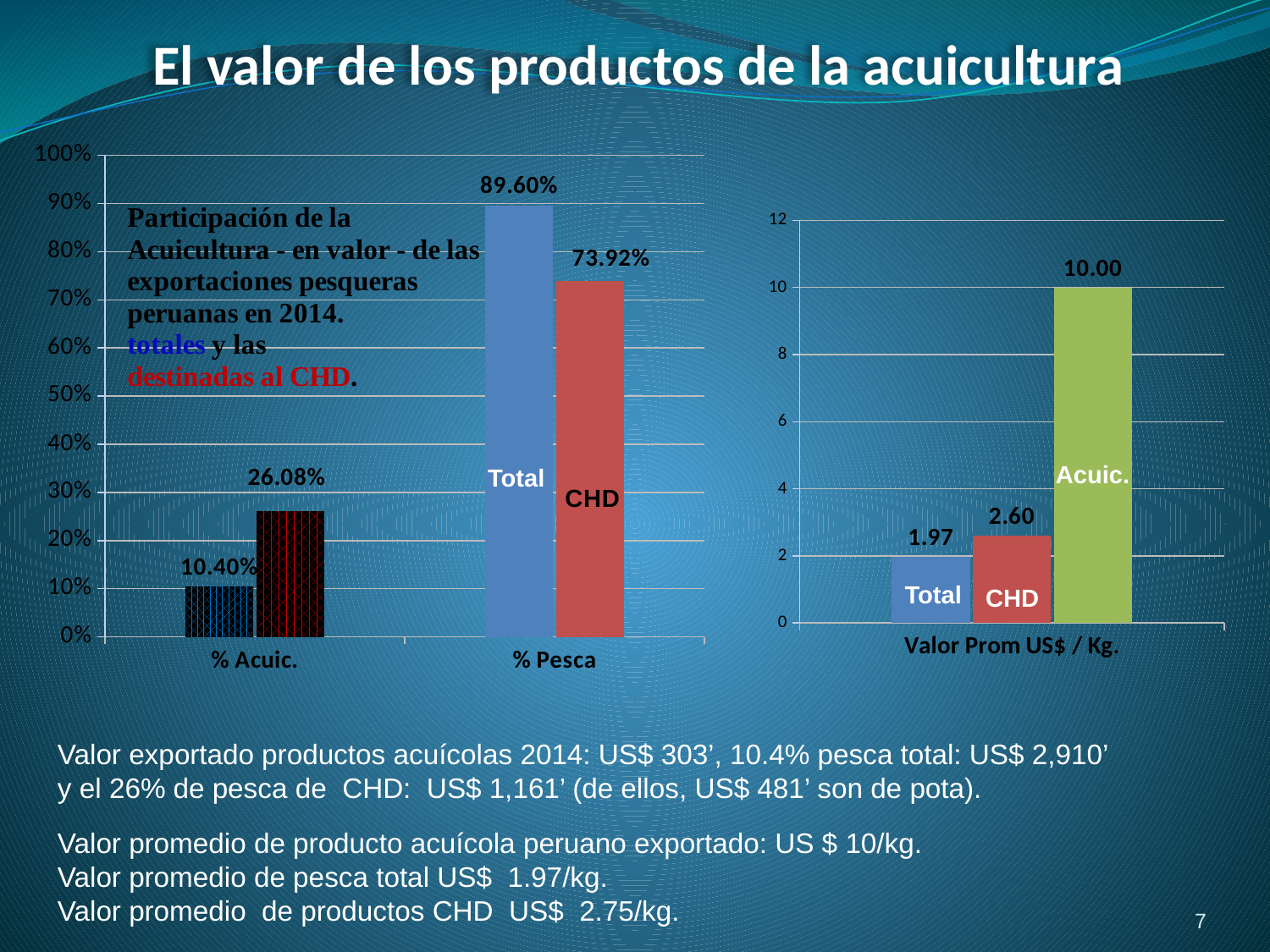
In the left chart, what is the difference between the Total and CHD values for % Pesca? 15.68% In the right chart (Valor Prom US$ / Kg.), what is the value for Acuic.? 10.00 How many bars are shown in the right chart (Valor Prom US$ / Kg.)? 3 In the right chart (Valor Prom US$ / Kg.), what is the value for CHD? 2.60 In the left chart, what is the CHD value for % Acuic.? 26.08% In the left chart, which is larger for % Acuic.: the Total bar or the CHD bar? CHD In the left chart, what is the Total value for % Acuic.? 10.40% In the right chart (Valor Prom US$ / Kg.), what is the difference between the Acuic. and Total values? 8.03 What type of chart is the left chart? Bar chart In the right chart (Valor Prom US$ / Kg.), which bar is the lowest? Total In the left chart, what is the Total value for % Pesca? 89.60% In the left chart, what is the CHD value for % Pesca? 73.92%